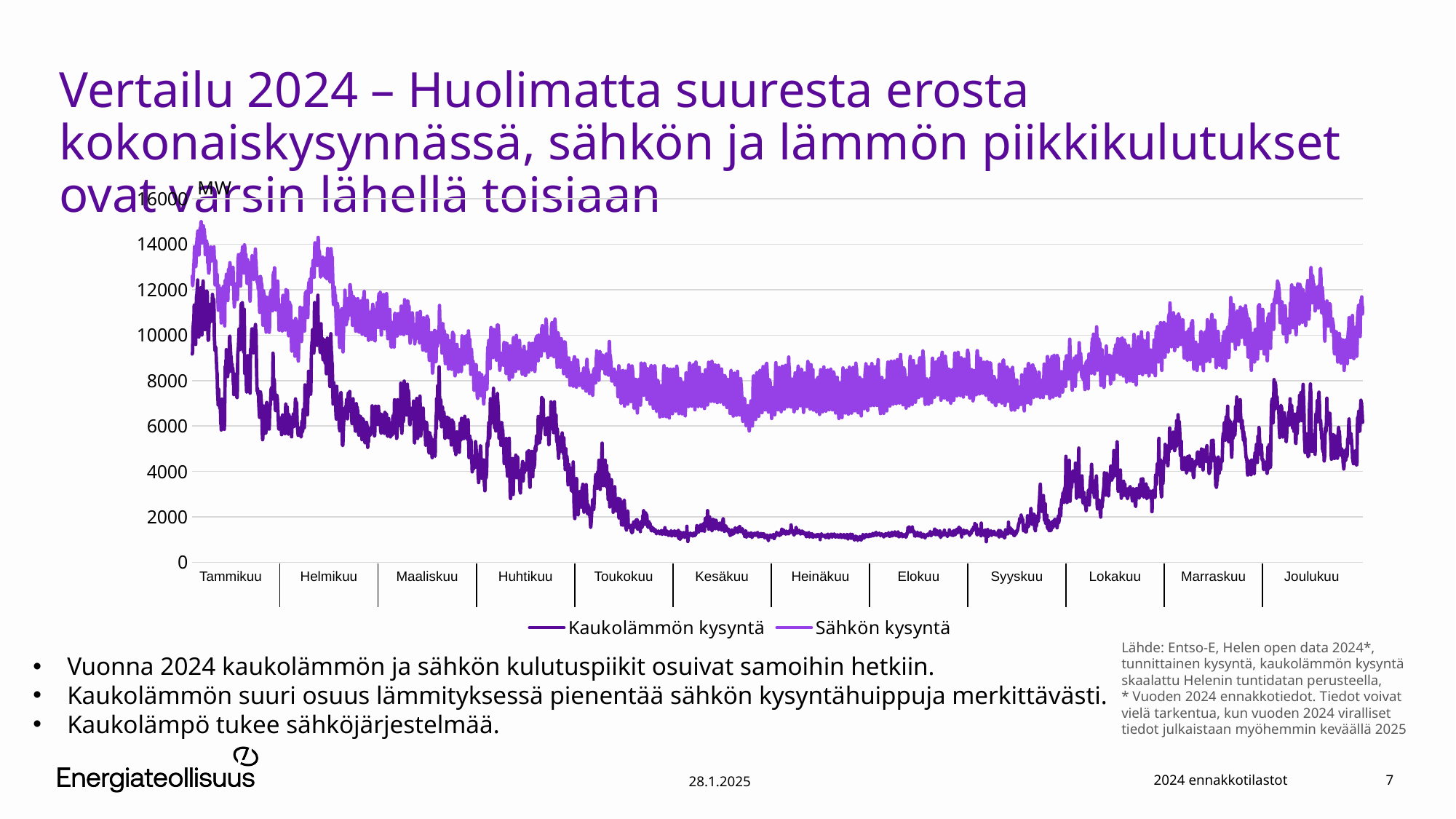
Is the peak value for Sähkön kysyntä in Tammikuu greater or less than 14000? greater How many months are labelled along the x axis of the chart? 12 Which series has the higher values in Heinäkuu, Kaukolämmön kysyntä or Sähkön kysyntä? Sähkön kysyntä Is the value for Kaukolämmön kysyntä in Heinäkuu greater or less than 2000? less In which month does Sähkön kysyntä reach its highest peak? Tammikuu Is the value for Sähkön kysyntä in Heinäkuu greater or less than 10000? less How many series does the chart legend list? 2 What are the two series named in the chart legend? Kaukolämmön kysyntä and Sähkön kysyntä Does Kaukolämmön kysyntä rise or fall from Tammikuu to Heinäkuu? Fall What kind of chart is shown on the slide? Line chart What unit is shown on the y axis of the chart? MW